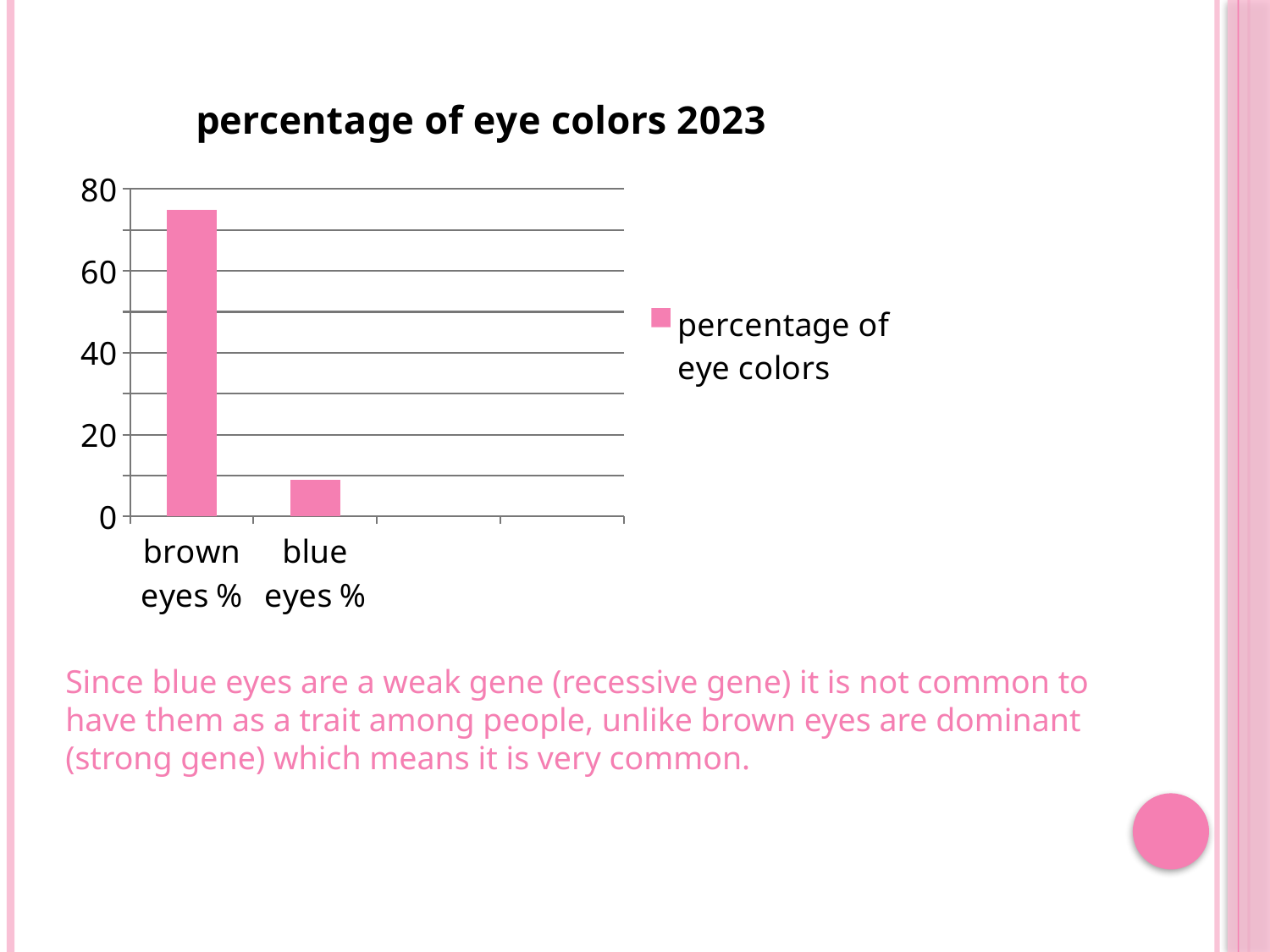
Is the value for brown eyes % greater or less than 60? greater Is the value for brown eyes % greater or less than 80? less What is the title of the chart? percentage of eye colors 2023 Do the values rise or fall from brown eyes % to blue eyes % along the x axis? fall Which category has the highest value in the chart? brown eyes % Which category has the lowest value in the chart? blue eyes % How many series does the chart's legend list? 1 What is the legend entry shown for the chart? percentage of eye colors How many categories are shown on the x axis of the chart? 2 Which is larger, the value for brown eyes % or the value for blue eyes %? brown eyes % What type of chart is shown on the slide? bar chart Is the value for blue eyes % greater or less than 20? less